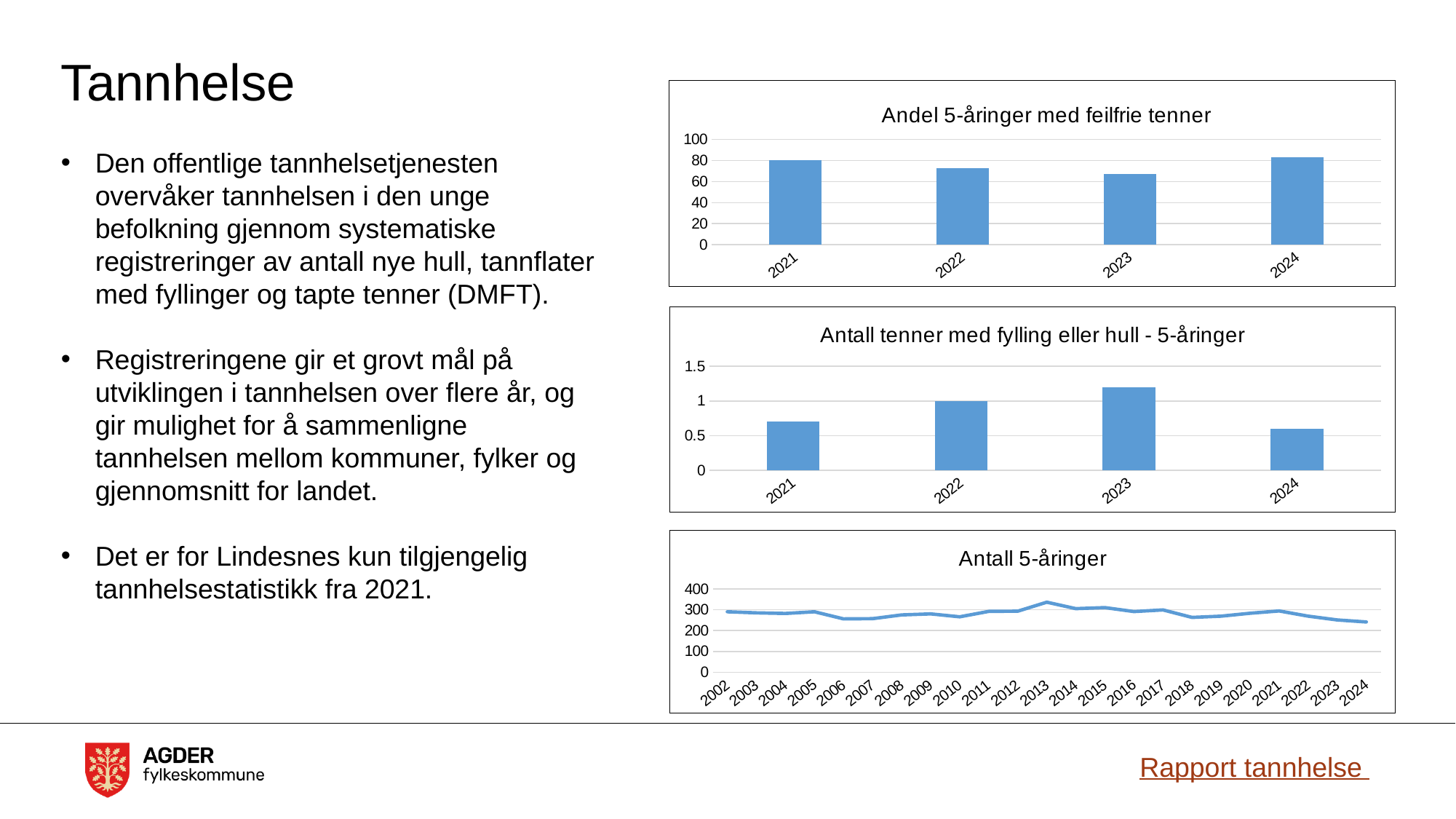
In the chart 'Antall tenner med fylling eller hull - 5-åringer', which year has the highest value? 2023 In the chart 'Antall tenner med fylling eller hull - 5-åringer', which is larger, the value for 2021 or the value for 2022? 2022 In the chart 'Antall tenner med fylling eller hull - 5-åringer', which year has the lowest value? 2024 What kind of chart is 'Antall tenner med fylling eller hull - 5-åringer'? bar chart In the chart 'Andel 5-åringer med feilfrie tenner', which year has the lowest value? 2023 In the chart 'Andel 5-åringer med feilfrie tenner', is the value for 2024 greater or less than 80? greater In the chart 'Antall 5-åringer', is the value for 2013 greater or less than 300? greater In the chart 'Andel 5-åringer med feilfrie tenner', is the value for 2023 greater or less than 80? less In the chart 'Andel 5-åringer med feilfrie tenner', which year has the highest value? 2024 What kind of chart is 'Antall 5-åringer'? line chart In the chart 'Andel 5-åringer med feilfrie tenner', how many years are shown? 4